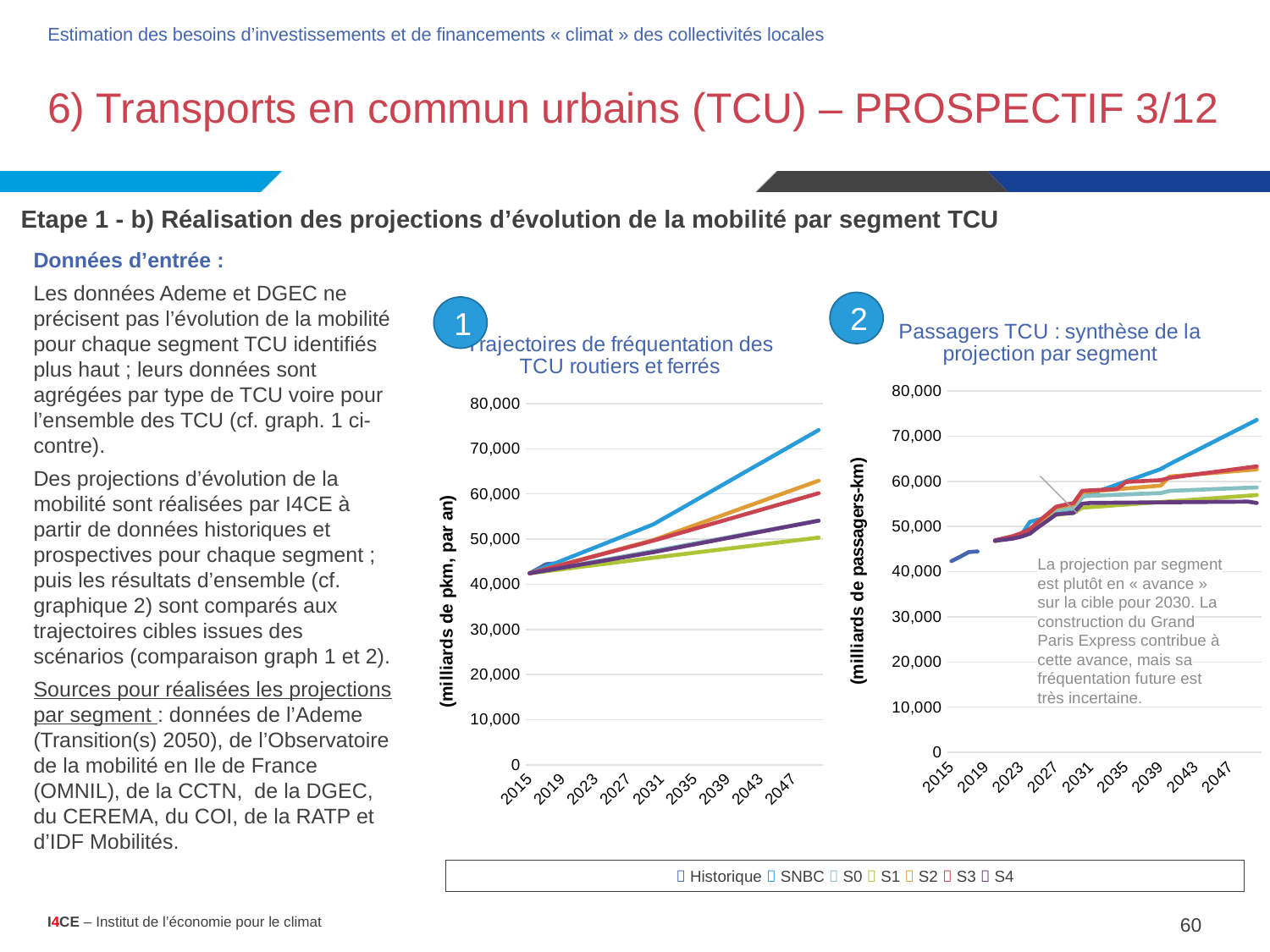
In the chart "Trajectoires de fréquentation des TCU routiers et ferrés", is the value of the lowest line in 2047 greater or less than 60,000? less In the chart "Trajectoires de fréquentation des TCU routiers et ferrés", do the plotted values rise or fall from 2015 to 2047? rise What kind of chart is the chart titled "Passagers TCU : synthèse de la projection par segment"? line chart How many series does the shared legend below the two charts list? 7 How many year labels are shown on the x axis of the chart "Trajectoires de fréquentation des TCU routiers et ferrés"? 9 What is the y-axis label of the chart "Passagers TCU : synthèse de la projection par segment"? (milliards de passagers-km) What kind of chart is the chart titled "Trajectoires de fréquentation des TCU routiers et ferrés"? line chart In the chart "Passagers TCU : synthèse de la projection par segment", do the plotted values rise or fall from 2015 to 2047? rise In the chart "Trajectoires de fréquentation des TCU routiers et ferrés", are the values in 2015 greater or less than 50,000? less In the chart "Passagers TCU : synthèse de la projection par segment", is the value of the lowest line in 2047 greater or less than 50,000? greater